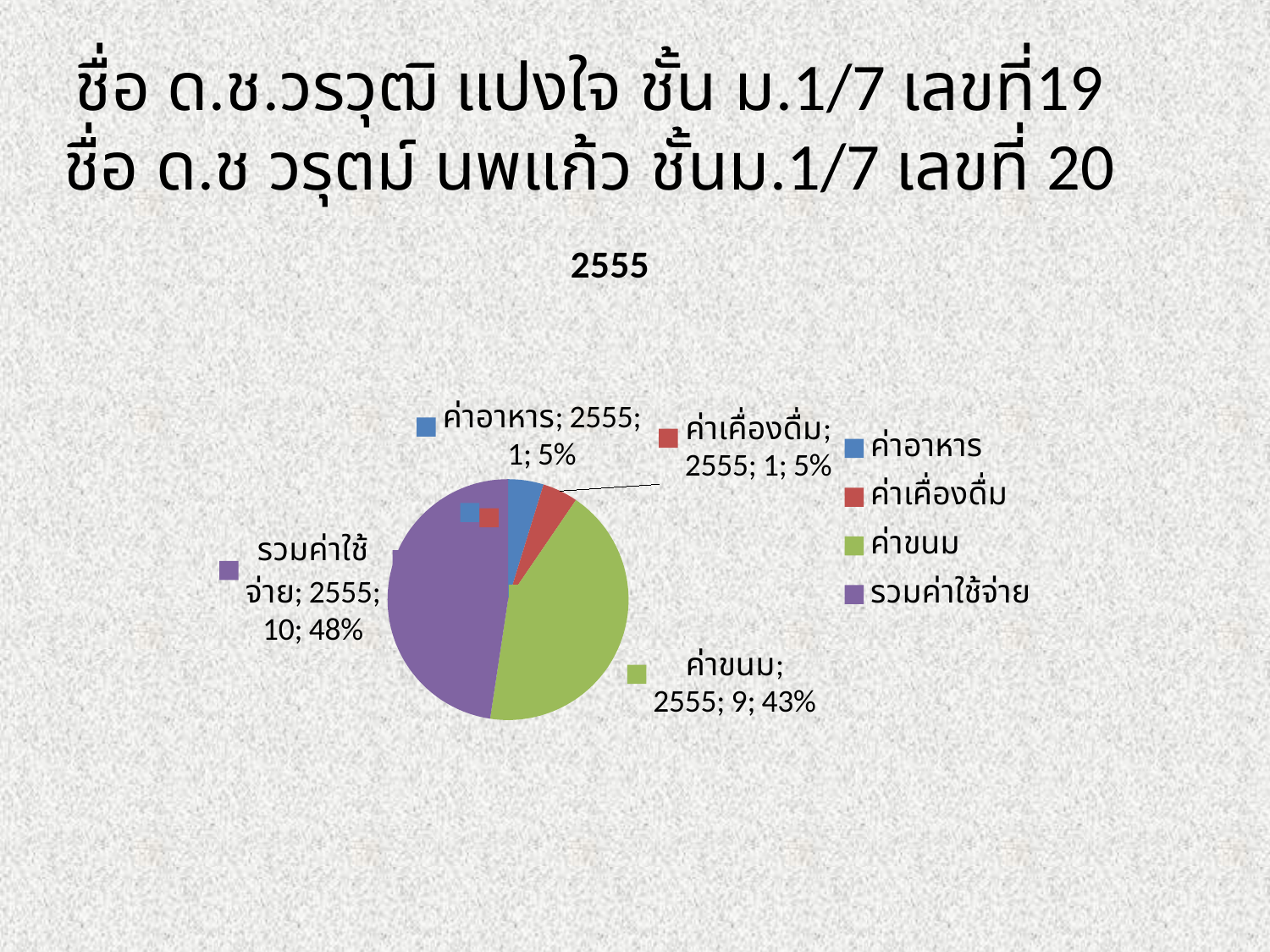
What is the title of the chart? 2555 Which is larger, the value for ค่าขนม or the value for ค่าเครื่องดื่ม? ค่าขนม What is the difference between the values for รวมค่าใช้จ่าย and ค่าขนม? 1 What share of the pie does รวมค่าใช้จ่าย represent? 48% What is the value for ค่าขนม? 9 How many entries does the legend list? 4 What is the value for รวมค่าใช้จ่าย? 10 What share of the pie does ค่าขนม represent? 43% How many slices does the pie chart have? 4 Which category has the largest slice? รวมค่าใช้จ่าย What kind of chart is shown on the slide? pie chart What is the value for ค่าอาหาร? 1